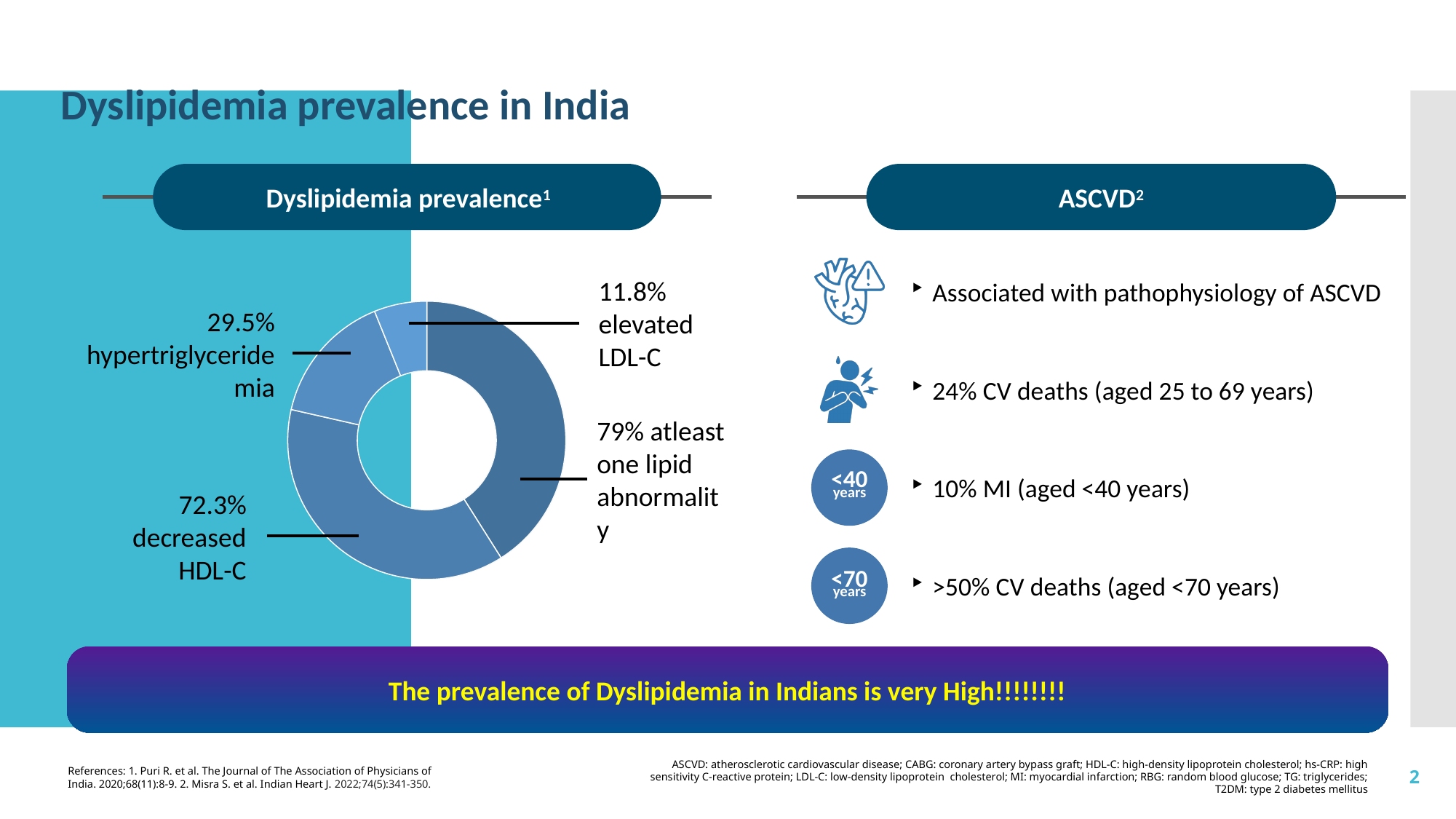
What is the difference between the percentages for hypertriglyceridemia and elevated LDL-C in the donut chart? 17.7 percentage points How many segments does the donut chart have? 4 Which segment of the donut chart has the highest percentage? At least one lipid abnormality (79%) Which segment of the donut chart has the lowest percentage? Elevated LDL-C (11.8%) What percentage is shown for hypertriglyceridemia in the donut chart? 29.5% What is the difference between the percentages for decreased HDL-C and hypertriglyceridemia in the donut chart? 42.8 percentage points What percentage is shown for elevated LDL-C in the donut chart? 11.8% What percentage is shown for decreased HDL-C in the donut chart? 72.3% In the donut chart, which is larger: decreased HDL-C or hypertriglyceridemia? Decreased HDL-C What is the heading above the donut chart? Dyslipidemia prevalence What kind of chart is shown under the 'Dyslipidemia prevalence' heading? Pie (donut) chart What percentage is shown for at least one lipid abnormality in the donut chart? 79%